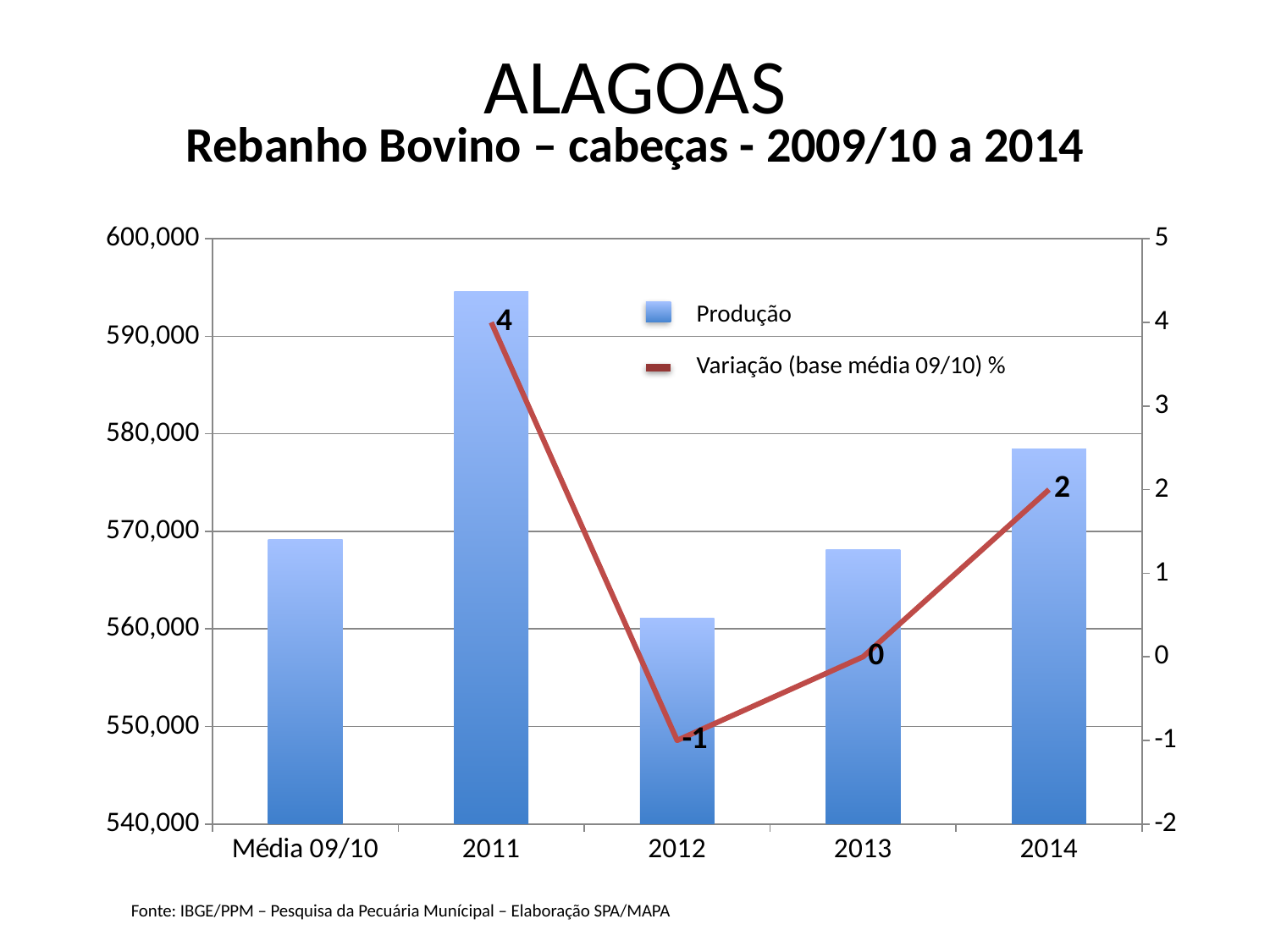
Is the Produção value for 2011 greater or less than 590,000? greater What is the value of Variação (base média 09/10) % for 2013? 0 What is the difference between the Variação values for 2011 and 2012? 5 Which category has the highest Produção bar? 2011 What is the value of Variação (base média 09/10) % for 2014? 2 Is the Produção value for 2012 greater or less than 570,000? less How many categories are shown on the x axis? 5 What is the value of Variação (base média 09/10) % for 2011? 4 What is the value of Variação (base média 09/10) % for 2012? -1 Which has the larger Produção bar, 2013 or 2014? 2014 How many series does the legend list? 2 Which category has the lowest Produção bar? 2012